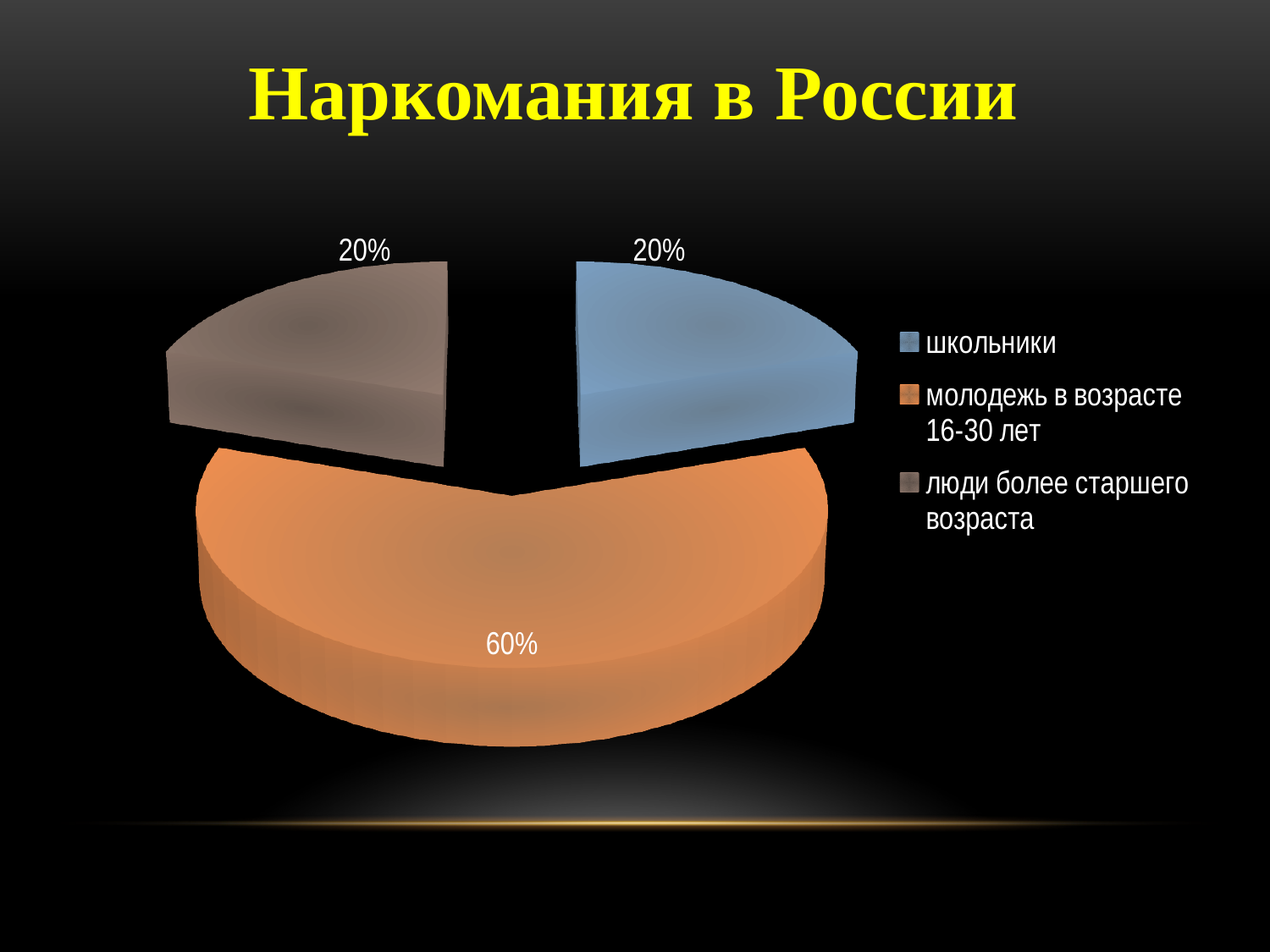
What kind of chart is shown on the slide? pie chart What share of the pie does the slice for люди более старшего возраста represent? 20% Which category has the largest slice of the pie? молодежь в возрасте 16-30 лет What is the title of the slide containing the pie chart? Наркомания в России What share of the pie does the slice for школьники represent? 20% What is the difference between the share for молодежь в возрасте 16-30 лет and the share for школьники? 40% What is the combined share of школьники and люди более старшего возраста? 40% Which category is shown in blue in the pie chart? школьники Is the share for школьники greater or less than 50%? less Which is larger: the share for молодежь в возрасте 16-30 лет or the share for люди более старшего возраста? молодежь в возрасте 16-30 лет What share of the pie does the slice for молодежь в возрасте 16-30 лет represent? 60% How many slices does the pie chart have? 3